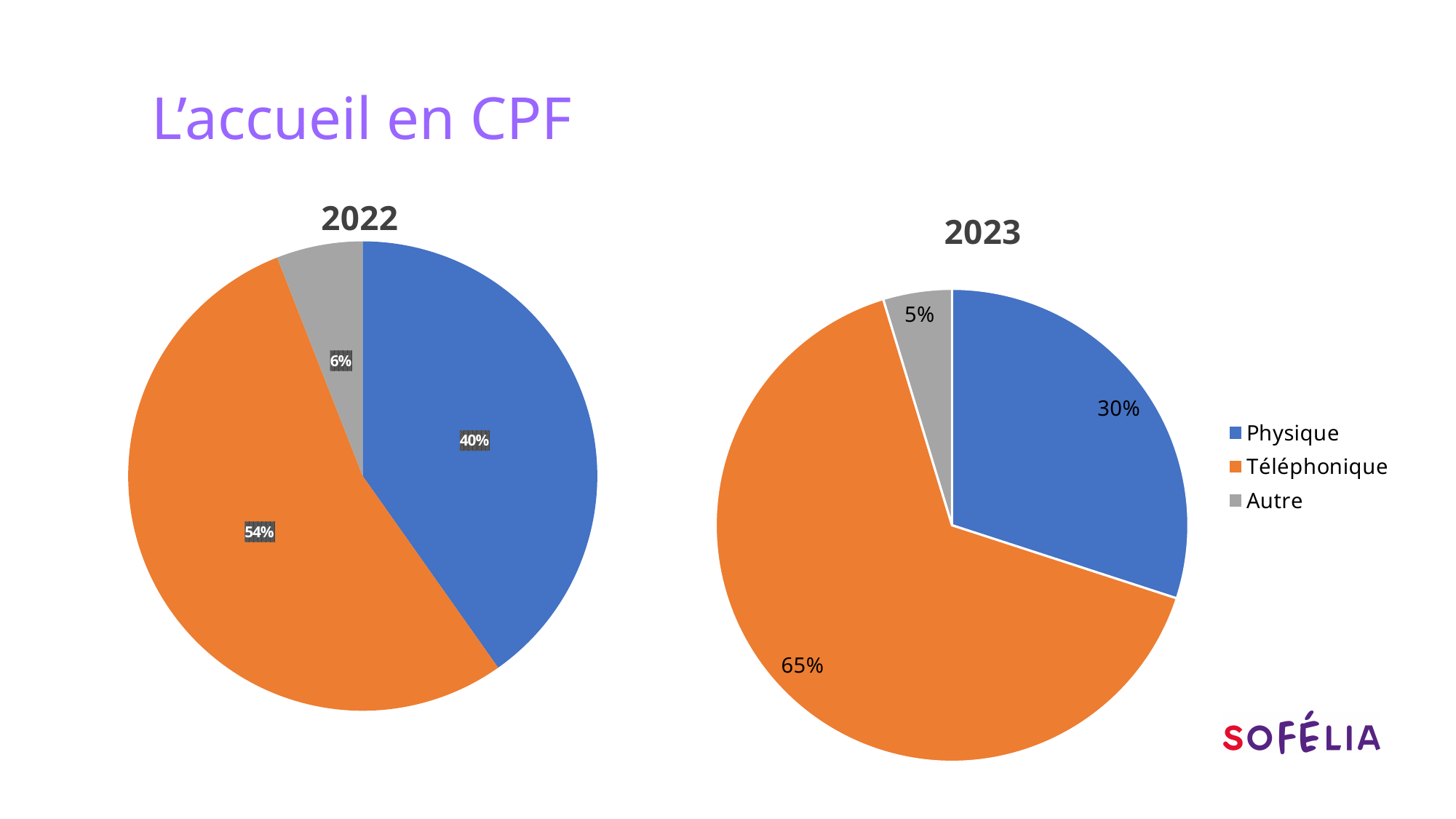
In the 2022 pie chart, what share is Physique? 40% In the 2022 pie chart, what is the difference between the Téléphonique and Physique shares? 14% In the 2023 pie chart, is the Physique slice larger or smaller than the Autre slice? larger In the 2022 pie chart, which category has the smallest slice? Autre In the 2023 pie chart, what share is Téléphonique? 65% What type of chart is used for 2022 and 2023? pie chart What colour represents Téléphonique in the pie charts? orange In the 2023 pie chart, what share is Autre? 5% In the 2023 pie chart, which category has the largest slice? Téléphonique In the 2023 pie chart, what is the difference between the Téléphonique and Physique shares? 35% How many categories does the legend list? 3 In the 2022 pie chart, what share is Téléphonique? 54%